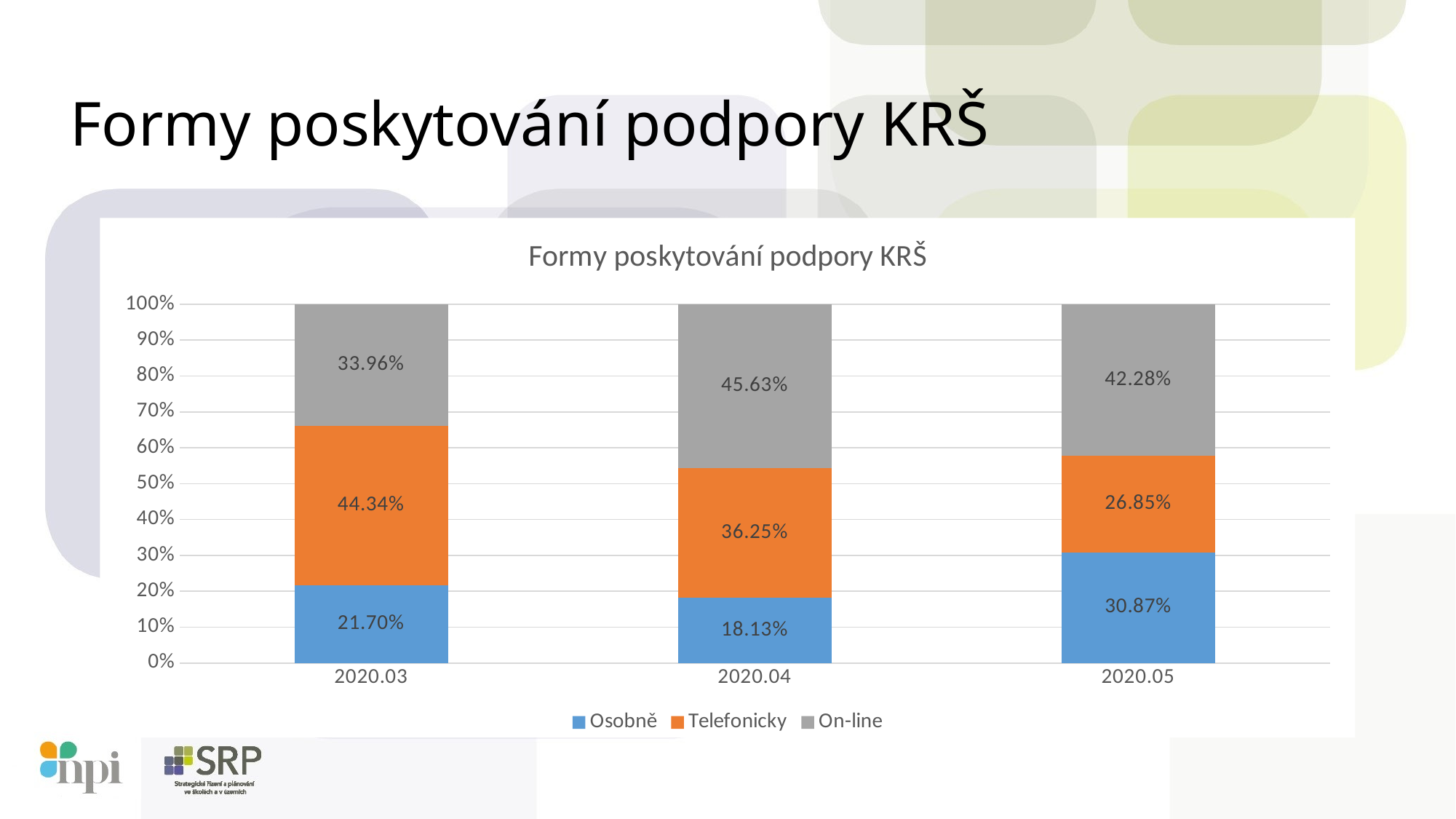
What kind of chart is shown? Stacked bar chart Which colour represents the Telefonicky series? Orange In which period is the Osobně share highest? 2020.05 Which is larger in 2020.04: Telefonicky or On-line? On-line How many periods are shown on the x axis? 3 What is the value for On-line in 2020.04? 45.63% What is the difference between the Telefonicky values for 2020.03 and 2020.05? 17.49% What is the value for On-line in 2020.05? 42.28% What is the value for Telefonicky in 2020.04? 36.25% In which period is the Telefonicky share lowest? 2020.05 What is the value for Osobně in 2020.03? 21.70% How many series does the legend list? 3